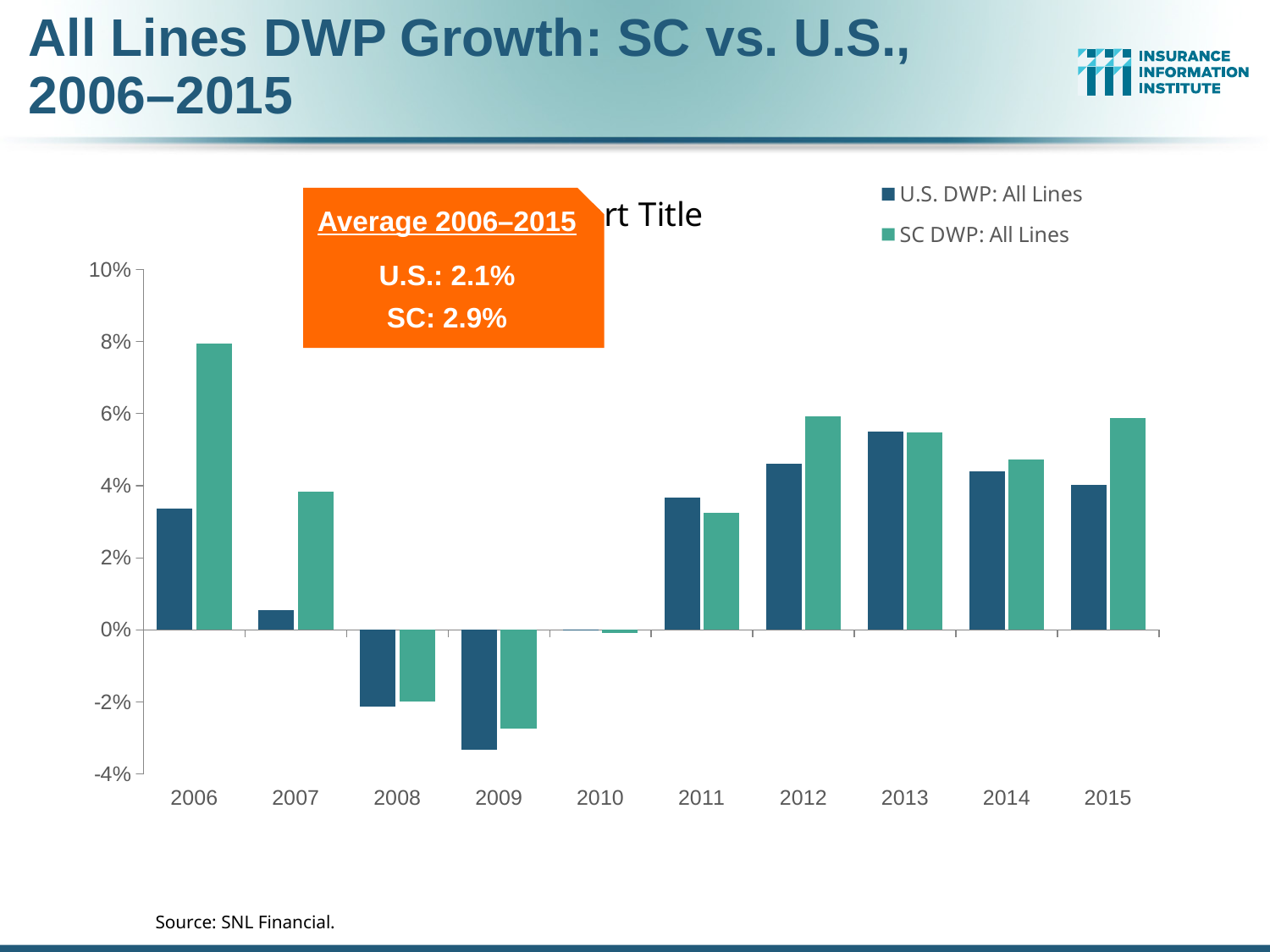
What kind of chart is shown on the slide? bar chart Is the SC DWP: All Lines value for 2006 greater or less than 6%? greater Is the U.S. DWP: All Lines value for 2007 greater or less than 2%? less Is the U.S. DWP: All Lines value for 2009 greater or less than -2%? less According to the orange box, what is the SC average DWP growth for 2006–2015? 2.9% In 2011, which series has the larger value, U.S. DWP: All Lines or SC DWP: All Lines? U.S. DWP: All Lines In which year is the SC DWP: All Lines growth highest? 2006 In 2015, which series has the larger value, U.S. DWP: All Lines or SC DWP: All Lines? SC DWP: All Lines In which year is the U.S. DWP: All Lines growth highest? 2013 How many years are shown on the x axis? 10 In which year is the U.S. DWP: All Lines growth lowest? 2009 How many series does the legend list? 2